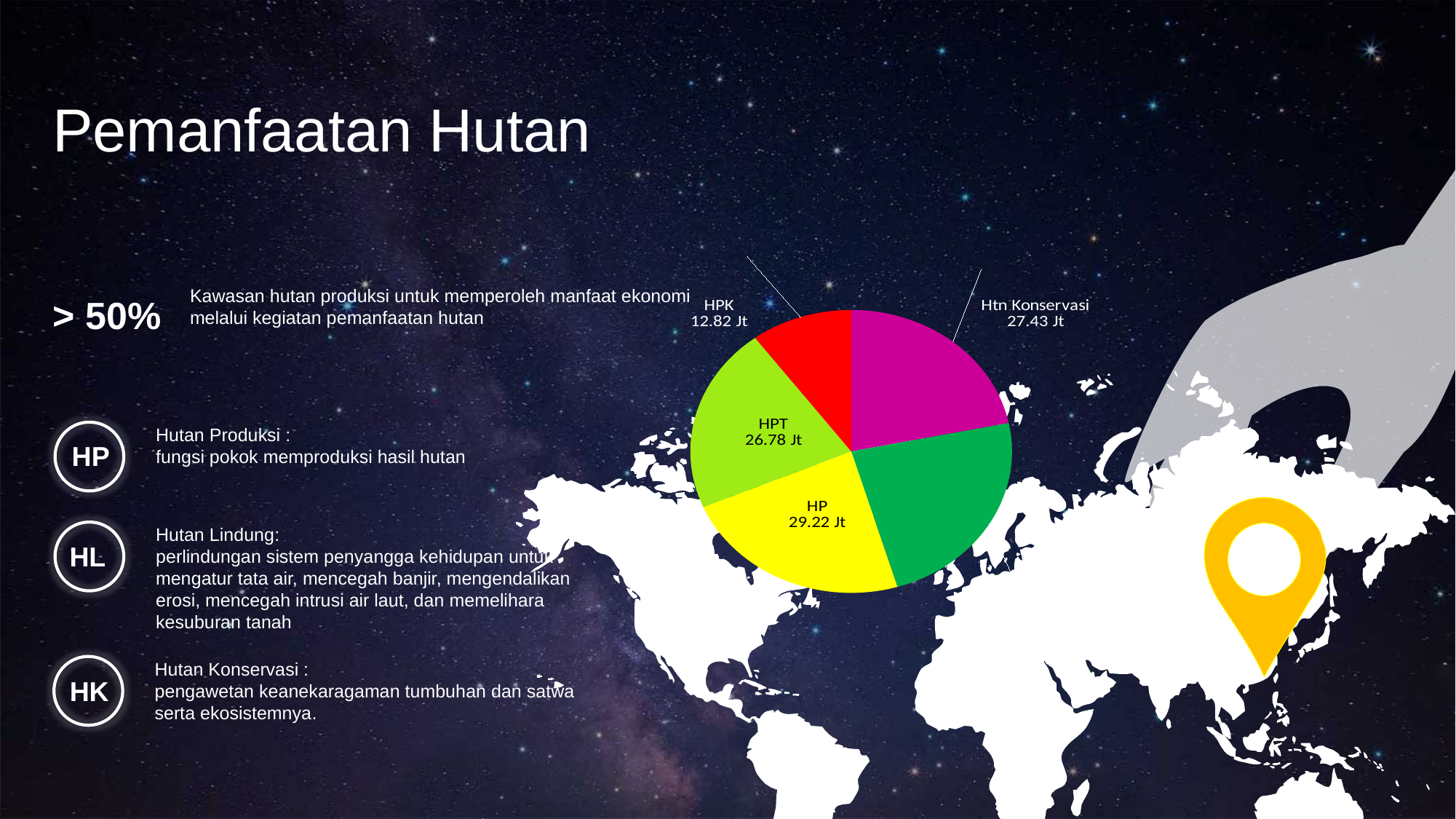
What colour is the HP slice in the pie chart? yellow What is the value shown for HPK in the pie chart? 12.82 Jt What is the difference between the values for HP and HPT? 2.44 Jt What is the value shown for HPT in the pie chart? 26.78 Jt What is the difference between the values for Htn Konservasi and HPK? 14.61 Jt Which is larger, HP or HPT? HP Which labelled slice of the pie chart has the smallest value? HPK How many slices does the pie chart have? 5 What kind of chart is shown on the slide? pie chart Which is larger, Htn Konservasi or HPK? Htn Konservasi What is the value shown for Htn Konservasi in the pie chart? 27.43 Jt What is the value shown for HP in the pie chart? 29.22 Jt